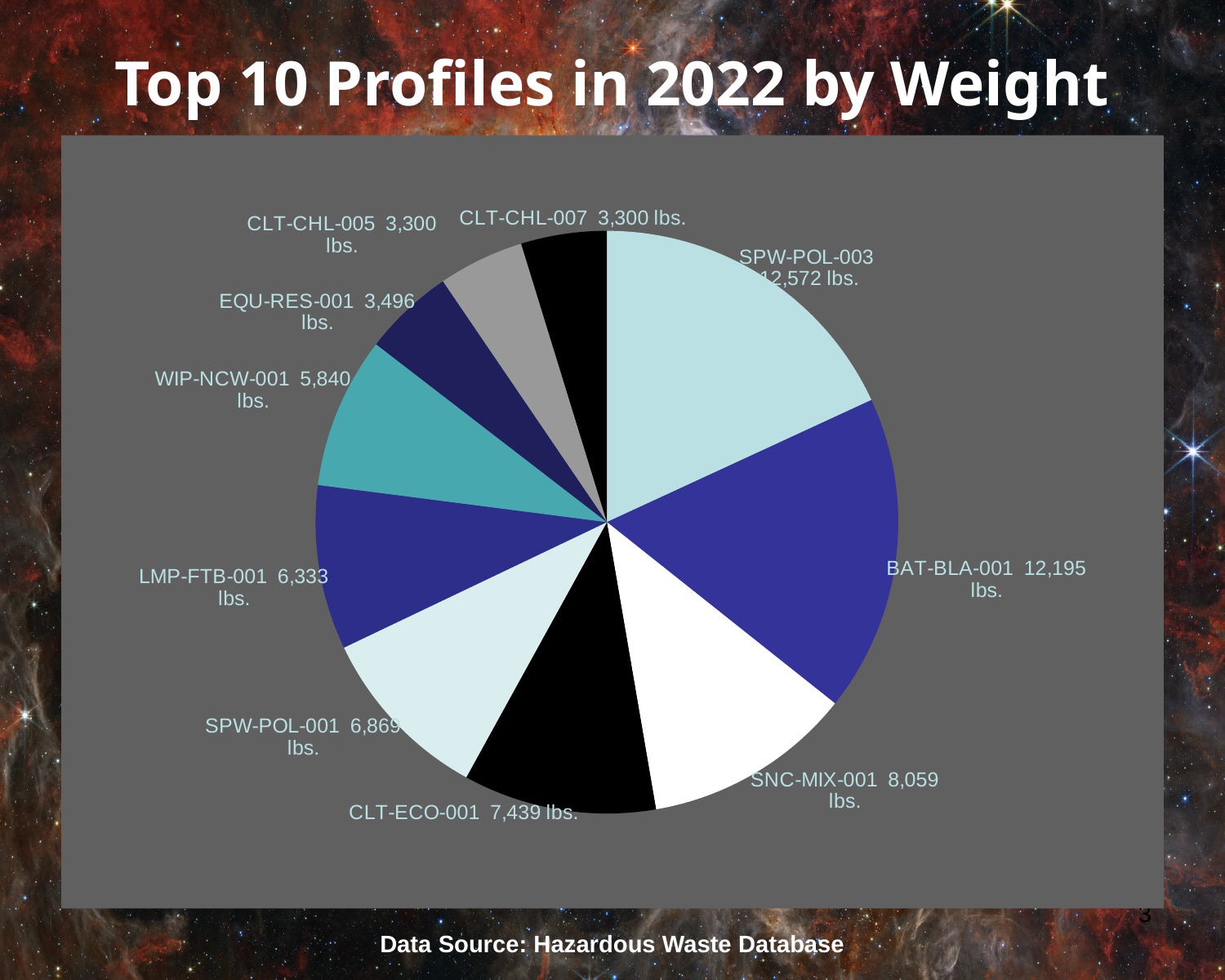
What is the lowest weight shown in the chart? 3,300 lbs. What is the weight for WIP-NCW-001? 5,840 lbs. What is the weight for CLT-ECO-001? 7,439 lbs. How many profiles (slices) are shown in the pie chart? 10 What is the title of the chart? Top 10 Profiles in 2022 by Weight What data source is cited for the chart? Hazardous Waste Database What is the difference in weight between SPW-POL-003 and BAT-BLA-001? 377 lbs. What kind of chart is shown on the slide? Pie chart Which profile has the highest weight? SPW-POL-003 What is the difference in weight between SNC-MIX-001 and CLT-ECO-001? 620 lbs. What is the weight for SPW-POL-003? 12,572 lbs. Which has a larger weight, SPW-POL-001 or LMP-FTB-001? SPW-POL-001